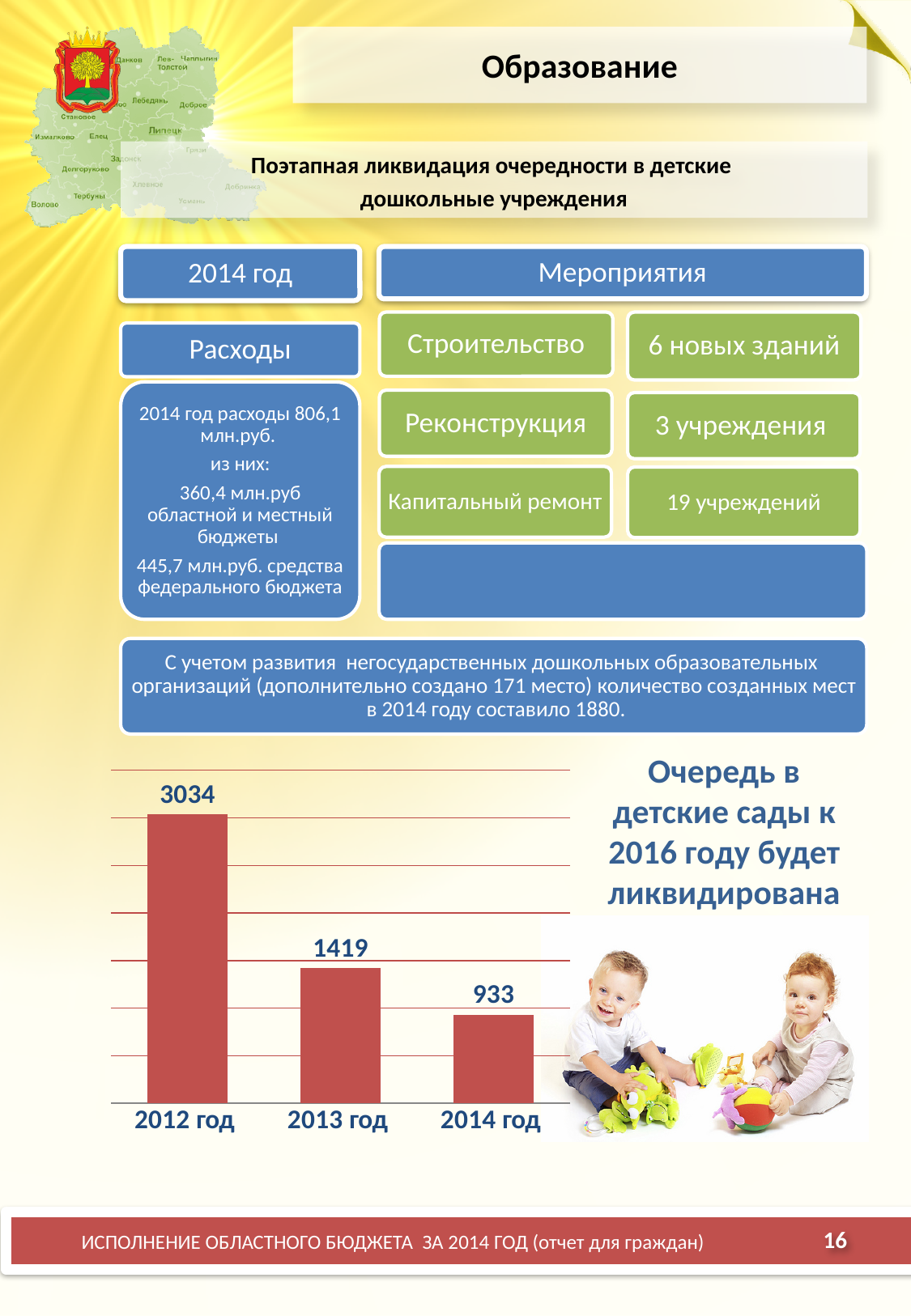
What kind of chart is shown on the slide? bar chart What is the value shown for 2014 год in the bar chart? 933 Which year has the highest bar in the chart? 2012 год What is the value shown for 2013 год in the bar chart? 1419 What is the difference between the values for 2012 год and 2013 год? 1615 What is the difference between the values for 2013 год and 2014 год? 486 Which is larger, the value for 2013 год or the value for 2014 год? 2013 год What colour are the bars in the chart? red Which year has the lowest bar in the chart? 2014 год How many bars are plotted in the chart? 3 Do the values in the chart rise or fall from 2012 год to 2014 год? fall What is the value shown for 2012 год in the bar chart? 3034